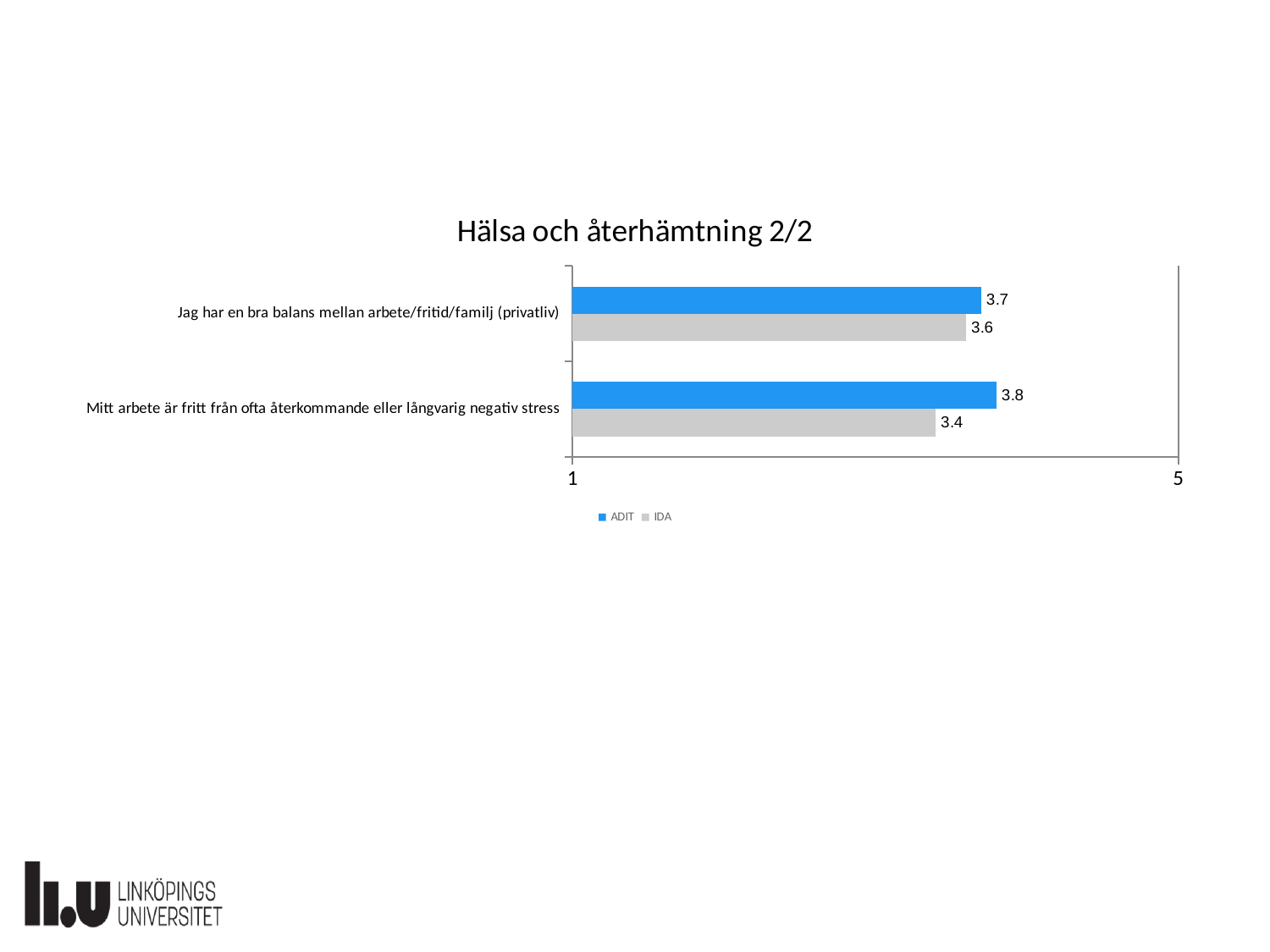
What is the title of the chart? Hälsa och återhämtning 2/2 What is the difference between the ADIT and IDA values for "Jag har en bra balans mellan arbete/fritid/familj (privatliv)"? 0.1 What is the ADIT value for "Jag har en bra balans mellan arbete/fritid/familj (privatliv)"? 3.7 What kind of chart is shown on the slide? Bar chart What is the ADIT value for "Mitt arbete är fritt från ofta återkommande eller långvarig negativ stress"? 3.8 What is the IDA value for "Mitt arbete är fritt från ofta återkommande eller långvarig negativ stress"? 3.4 Which series has the higher value for "Mitt arbete är fritt från ofta återkommande eller långvarig negativ stress", ADIT or IDA? ADIT What is the IDA value for "Jag har en bra balans mellan arbete/fritid/familj (privatliv)"? 3.6 What is the difference between the ADIT and IDA values for "Mitt arbete är fritt från ofta återkommande eller långvarig negativ stress"? 0.4 Which category has the lowest IDA value? Mitt arbete är fritt från ofta återkommande eller långvarig negativ stress How many series does the legend list? 2 How many categories are shown in the chart? 2